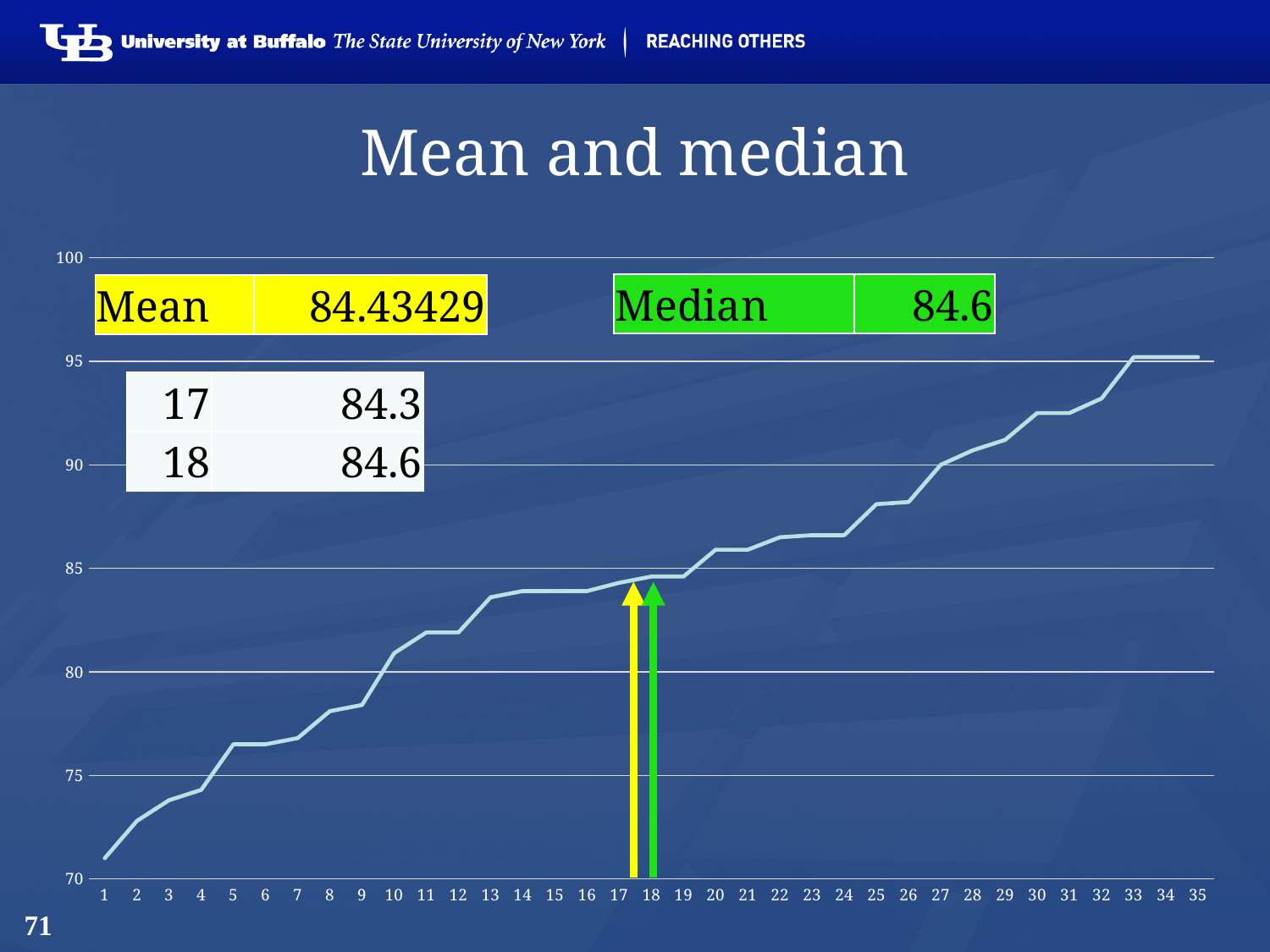
Which has the larger plotted value, position 5 or position 30? 30 How many data points are plotted along the x axis? 35 What kind of chart is shown on the slide? line chart Is the value at position 1 greater or less than 75? less Which position has the lowest plotted value? 1 Is the value at position 27 greater or less than 85? greater According to the table on the chart, what is the value at position 18? 84.6 Do the plotted values rise or fall as the x axis goes from 1 to 35? rise According to the table on the chart, what is the value at position 17? 84.3 What is the title of the slide's chart? Mean and median What mean value is shown in the yellow box? 84.43429 What is the difference between the values at positions 18 and 17? 0.3